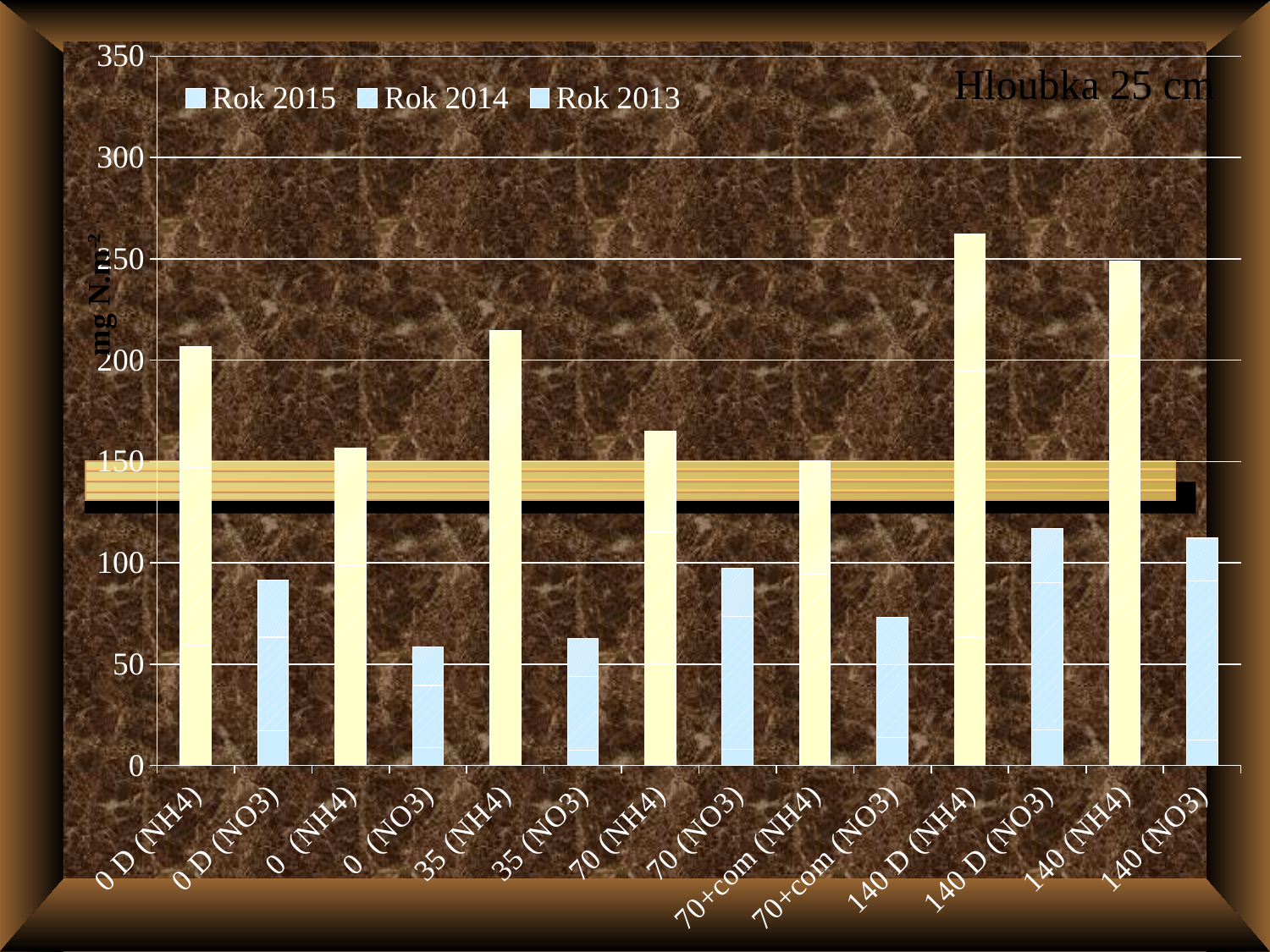
Which has the larger total bar, 0 D (NH4) or 0 (NH4)? 0 D (NH4) What kind of chart is shown on the slide? bar chart Is the total value for 70 (NH4) greater or less than 200? less Which has the larger total bar, 140 D (NO3) or 70 (NO3)? 140 D (NO3) How many series does the legend list? 3 What is the title shown on the chart? Hloubka 25 cm Is the total value for 140 D (NO3) greater or less than 100? greater How many categories are shown on the x axis? 14 Is the total value for 70+com (NO3) greater or less than 100? less Which category has the highest total bar? 140 D (NH4)